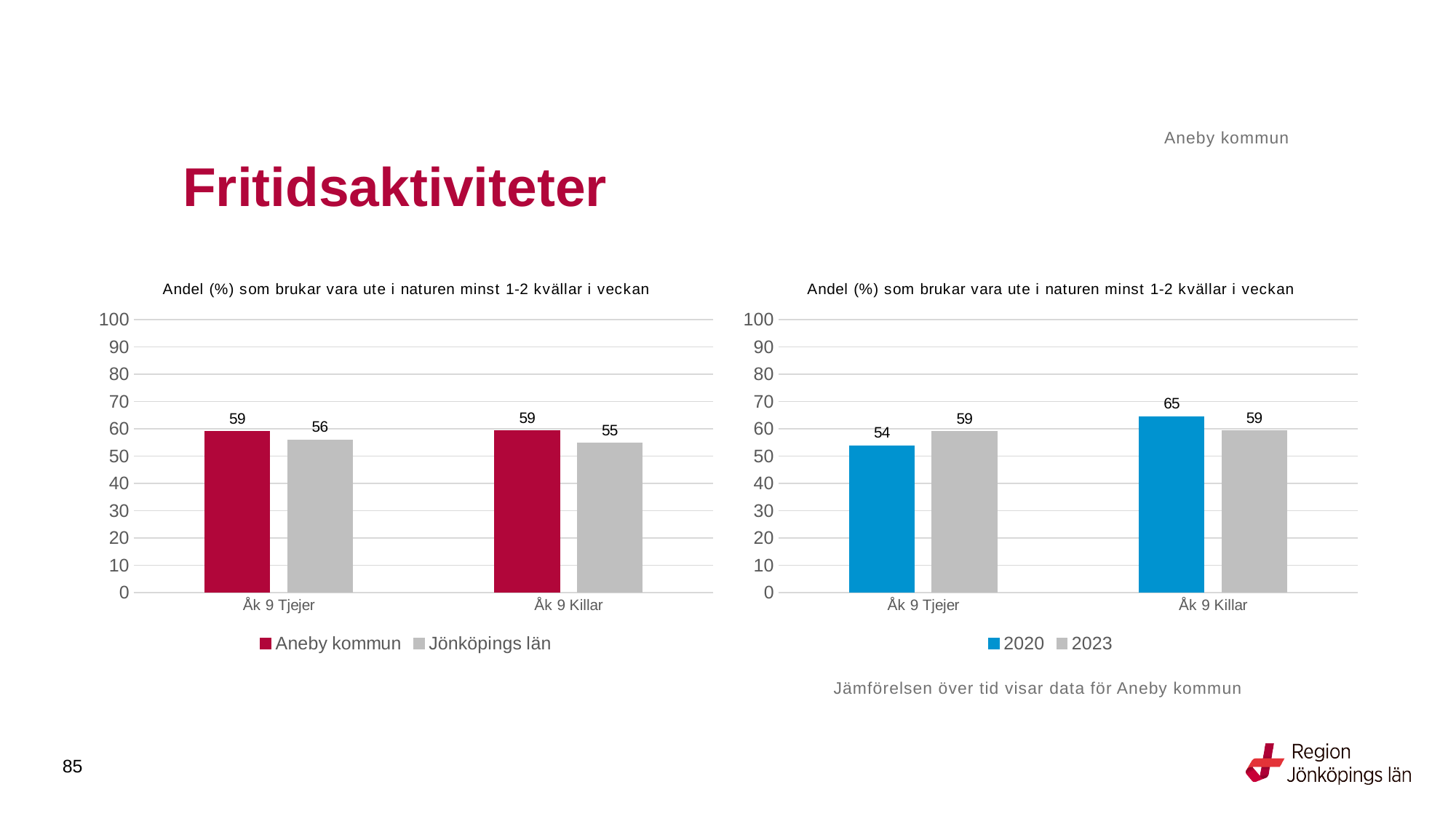
In the right chart, what is the value for 2020 for Åk 9 Killar? 65 What kind of chart is the left chart? bar chart In the left chart, what is the difference between Aneby kommun and Jönköpings län for Åk 9 Tjejer? 3 How many categories are shown on the x axis of the left chart? 2 In the right chart, what is the value for 2023 for Åk 9 Tjejer? 59 In the left chart, what is the value for Jönköpings län for Åk 9 Killar? 55 How many series does the legend of the right chart list? 2 In the right chart, did the value for Åk 9 Tjejer rise or fall from 2020 to 2023? rise In the right chart, what is the difference between 2020 and 2023 for Åk 9 Killar? 6 In the left chart, which series has the higher value for Åk 9 Killar, Aneby kommun or Jönköpings län? Aneby kommun In the right chart, which category has the lowest value across both series? Åk 9 Tjejer (2020) In the left chart, what is the value for Aneby kommun for Åk 9 Tjejer? 59